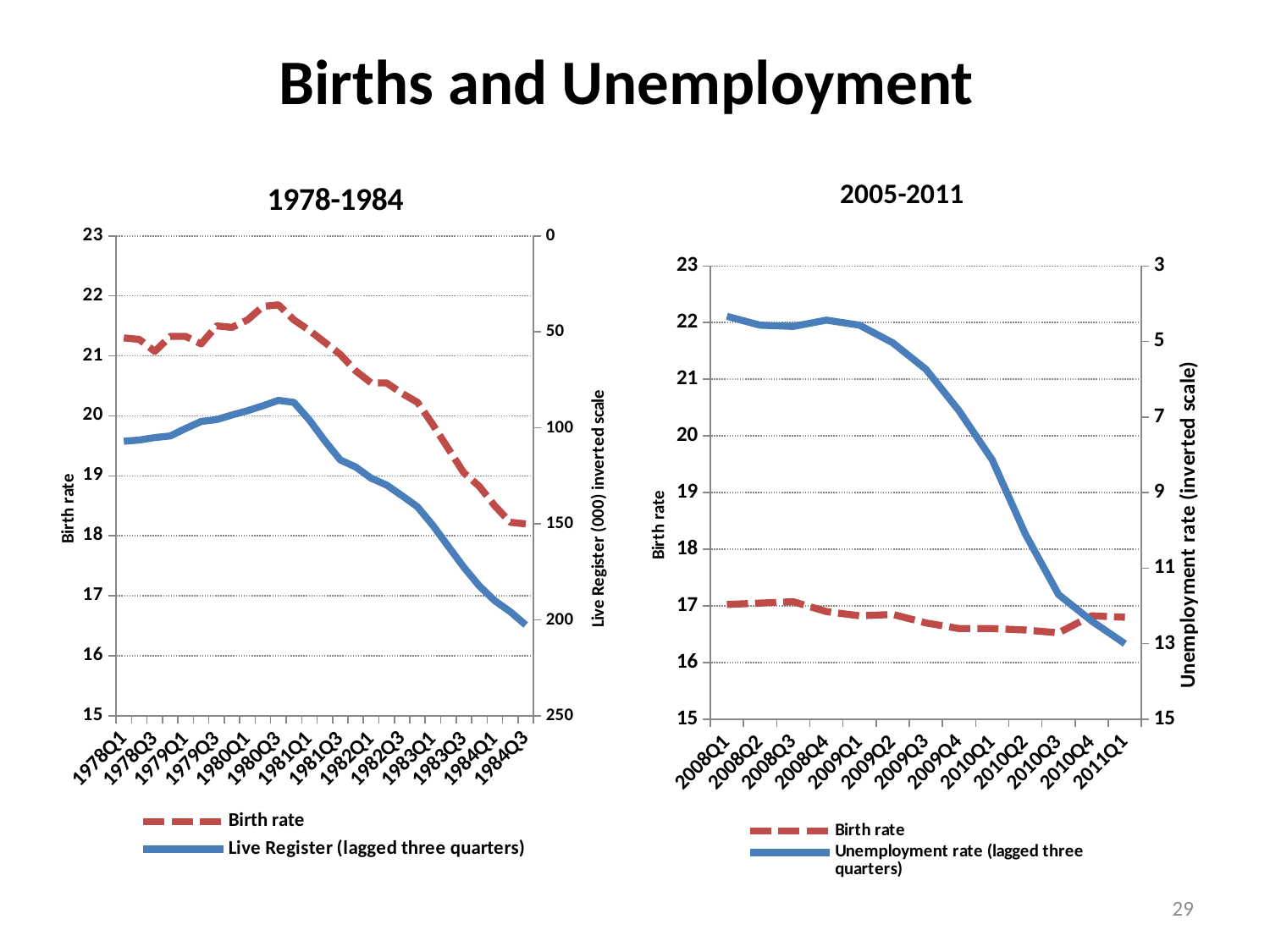
How many quarters are labelled on the x axis of the 2005-2011 chart? 13 In the 1978-1984 chart, in which quarter does the Birth rate line reach its highest point? 1980Q3 In the 2005-2011 chart, does the plotted Unemployment rate line rise or fall from 2009Q1 to 2011Q1? fall In the 1978-1984 chart, is the Birth rate at 1984Q3 greater or less than 19? less In the 1978-1984 chart, does the Birth rate line rise or fall from 1981Q1 to 1984Q3? fall In the 2005-2011 chart, is the Birth rate at 2010Q3 greater or less than 17? less What is the label of the right-hand vertical axis of the 2005-2011 chart? Unemployment rate (inverted scale) In the 2005-2011 chart, is the Birth rate higher at 2008Q3 or at 2010Q3? 2008Q3 In the 2005-2011 chart, is the Unemployment rate at 2008Q1 (right axis) greater or less than 5? less How many series does the legend of the 2005-2011 chart list? 2 What kind of chart is the 1978-1984 chart? line chart